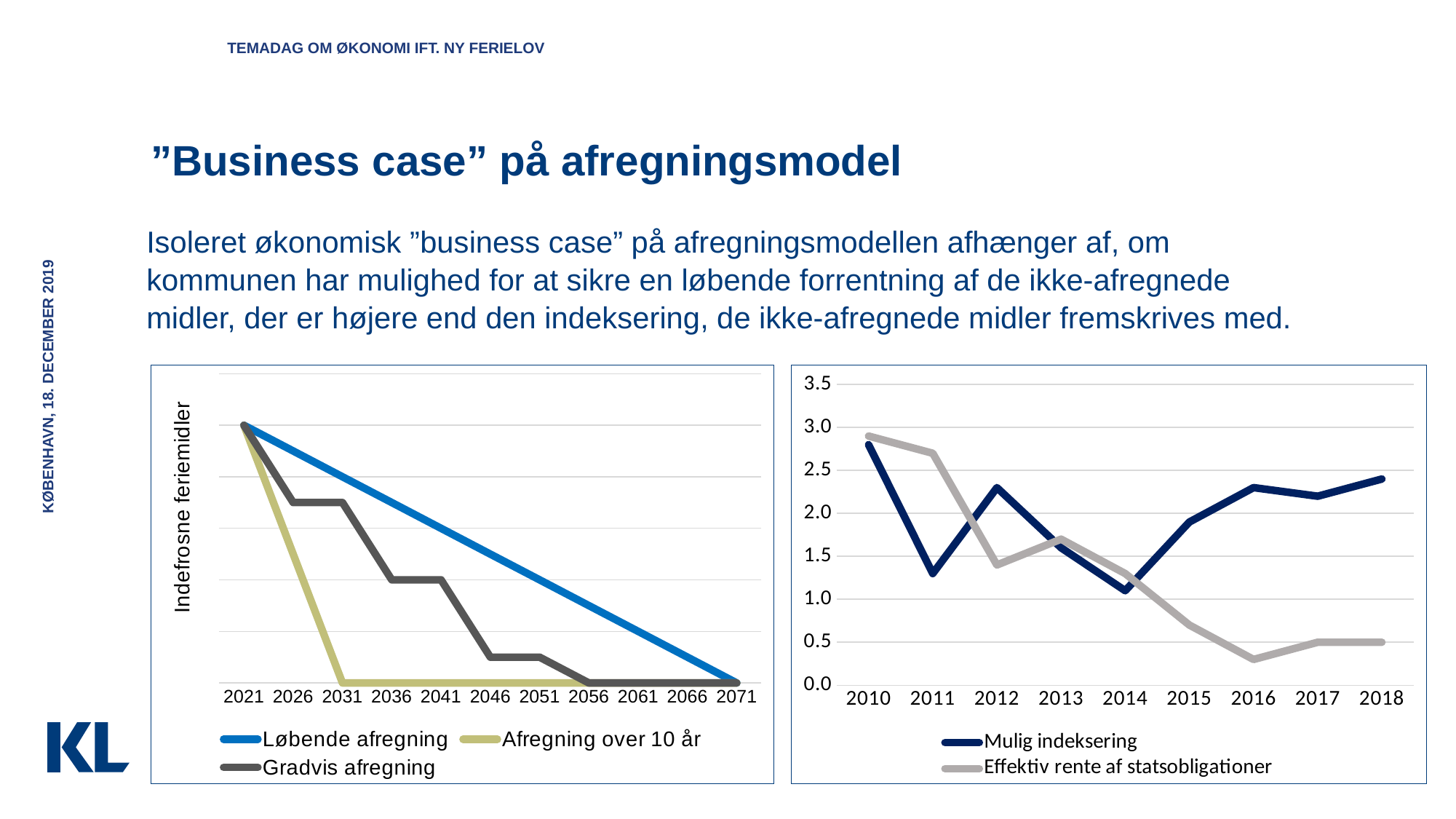
How many series does the legend of the right chart list? 2 In the left chart, which series reaches zero first along the x axis? Afregning over 10 år How many series does the legend of the left chart list? 3 In the left chart, do the values of Løbende afregning rise or fall from 2021 to 2071? fall In the right chart, is the value for Mulig indeksering in 2010 greater or less than 2.5? greater In the right chart, which series has the higher value in 2018? Mulig indeksering In the right chart, in which year is Effektiv rente af statsobligationer lowest? 2016 How many years are shown on the x axis of the right chart? 9 In the right chart, is the value for Effektiv rente af statsobligationer in 2016 greater or less than 0.5? less In the right chart, in which year is Mulig indeksering highest? 2010 In the left chart, in which year does the Løbende afregning line reach zero? 2071 What kind of chart is the left chart (Indefrosne feriemidler)? line chart